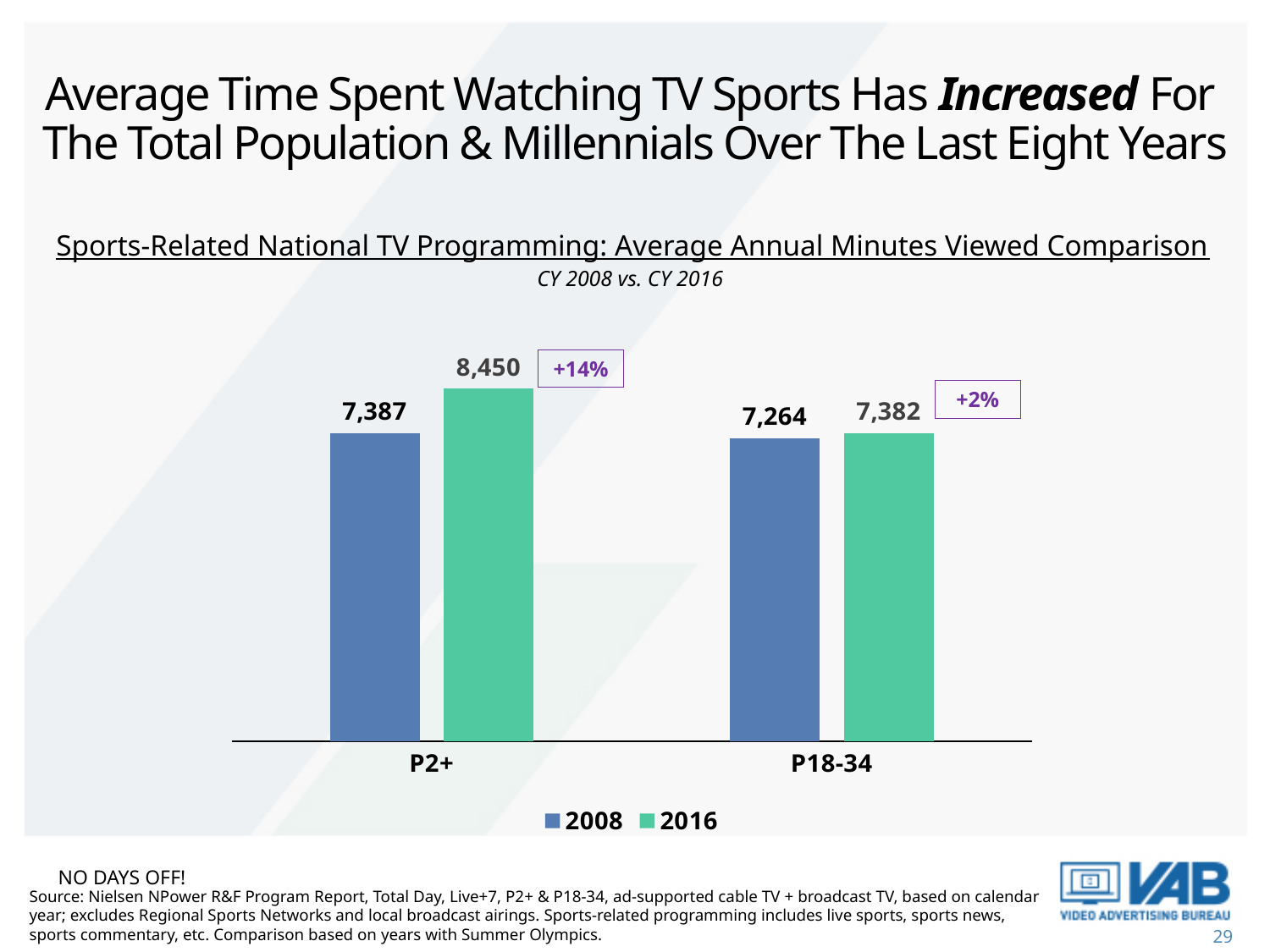
How many categories are shown on the x axis? 2 How many series does the legend list? 2 What is the difference between the 2016 and 2008 values for P18-34? 118 What is the value for P18-34 in 2016? 7,382 What is the value for P18-34 in 2008? 7,264 Which bar has the highest value on the chart? P2+ in 2016 What is the value for P2+ in 2016? 8,450 Which bar has the lowest value on the chart? P18-34 in 2008 What is the value for P2+ in 2008? 7,387 What kind of chart is shown on the slide? Bar chart What is the difference between the 2016 and 2008 values for P2+? 1,063 Which is larger, the 2016 value for P2+ or the 2016 value for P18-34? P2+